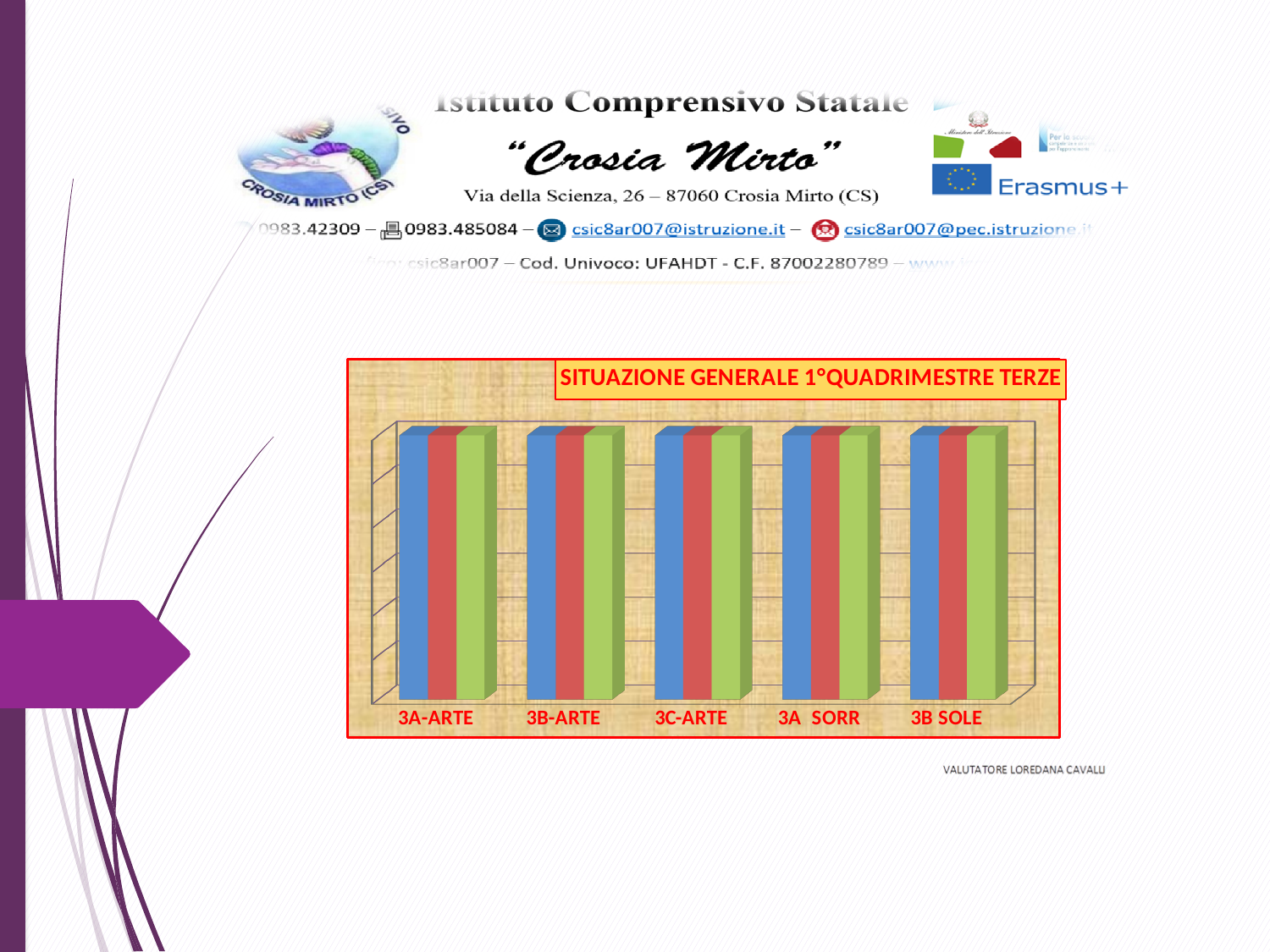
How many categories are shown on the x axis of the chart? 5 What is the label of the first category on the x axis of the chart? 3A-ARTE What kind of chart is shown on the slide? bar chart What is the label of the last category on the x axis of the chart? 3B SOLE What is the title of the chart? SITUAZIONE GENERALE 1°QUADRIMESTRE TERZE How many bars are plotted for each category in the chart? 3